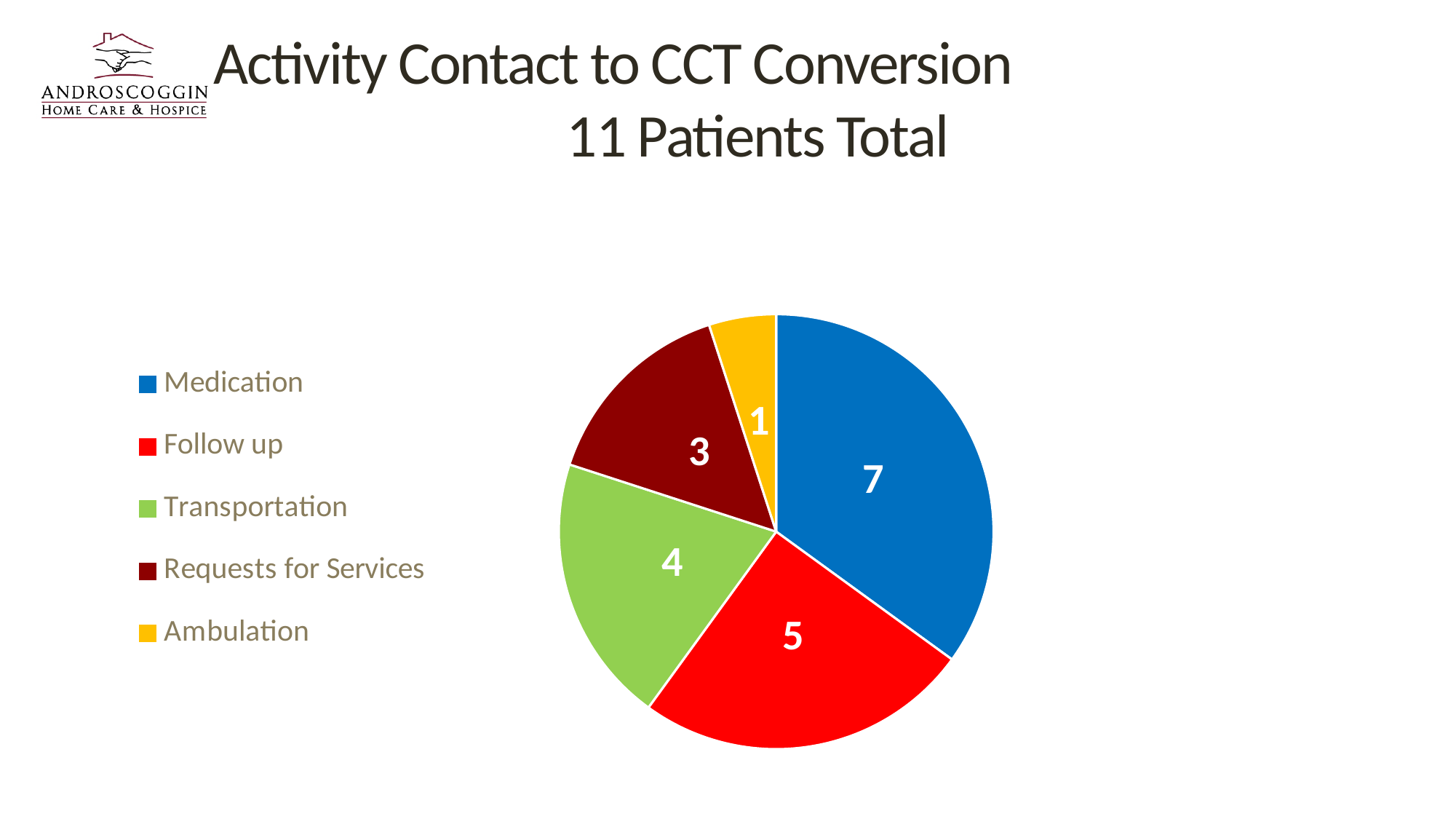
What is the difference between the values for Medication and Follow up? 2 What colour is the Ambulation slice? yellow What is the value for Requests for Services? 3 Which category has the largest slice? Medication How many categories does the legend list? 5 What is the value for Ambulation? 1 What is the value for Medication? 7 What is the value for Follow up? 5 Which category has the smallest slice? Ambulation Which is larger, Transportation or Requests for Services? Transportation What is the value for Transportation? 4 What type of chart is shown on the slide? pie chart